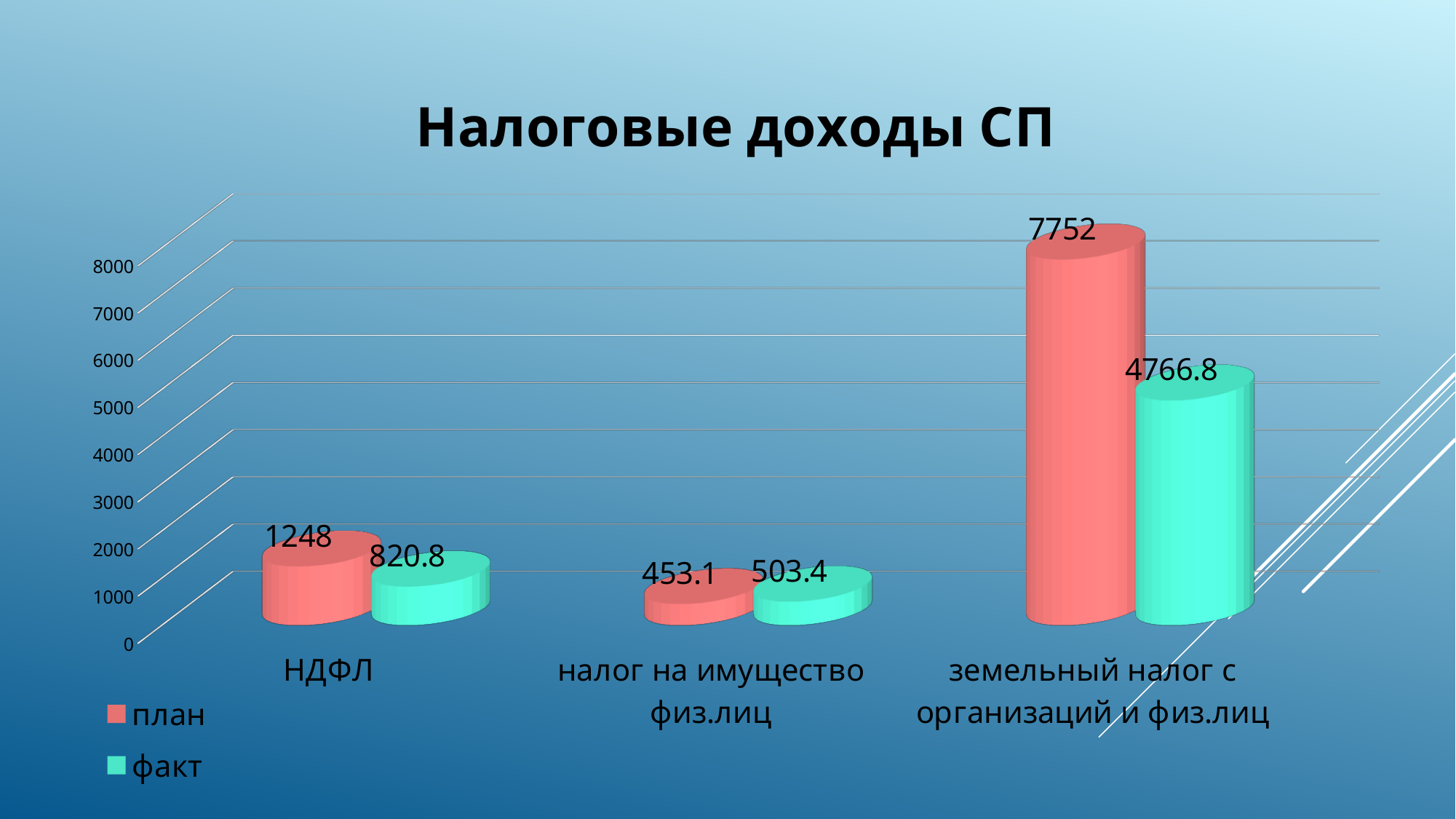
Which category has the lowest факт value? налог на имущество физ.лиц Which category has the highest план value? земельный налог с организаций и физ.лиц What is the title of the chart? Налоговые доходы СП How many series does the legend list? 2 What is the факт value for налог на имущество физ.лиц? 503.4 For налог на имущество физ.лиц, which is larger: план or факт? факт What is the факт value for земельный налог с организаций и физ.лиц? 4766.8 What kind of chart is shown on the slide? bar chart What is the difference between the план and факт values for земельный налог с организаций и физ.лиц? 2985.2 What is the план value for НДФЛ? 1248 What is the difference between the план and факт values for НДФЛ? 427.2 How many categories are shown on the x axis? 3